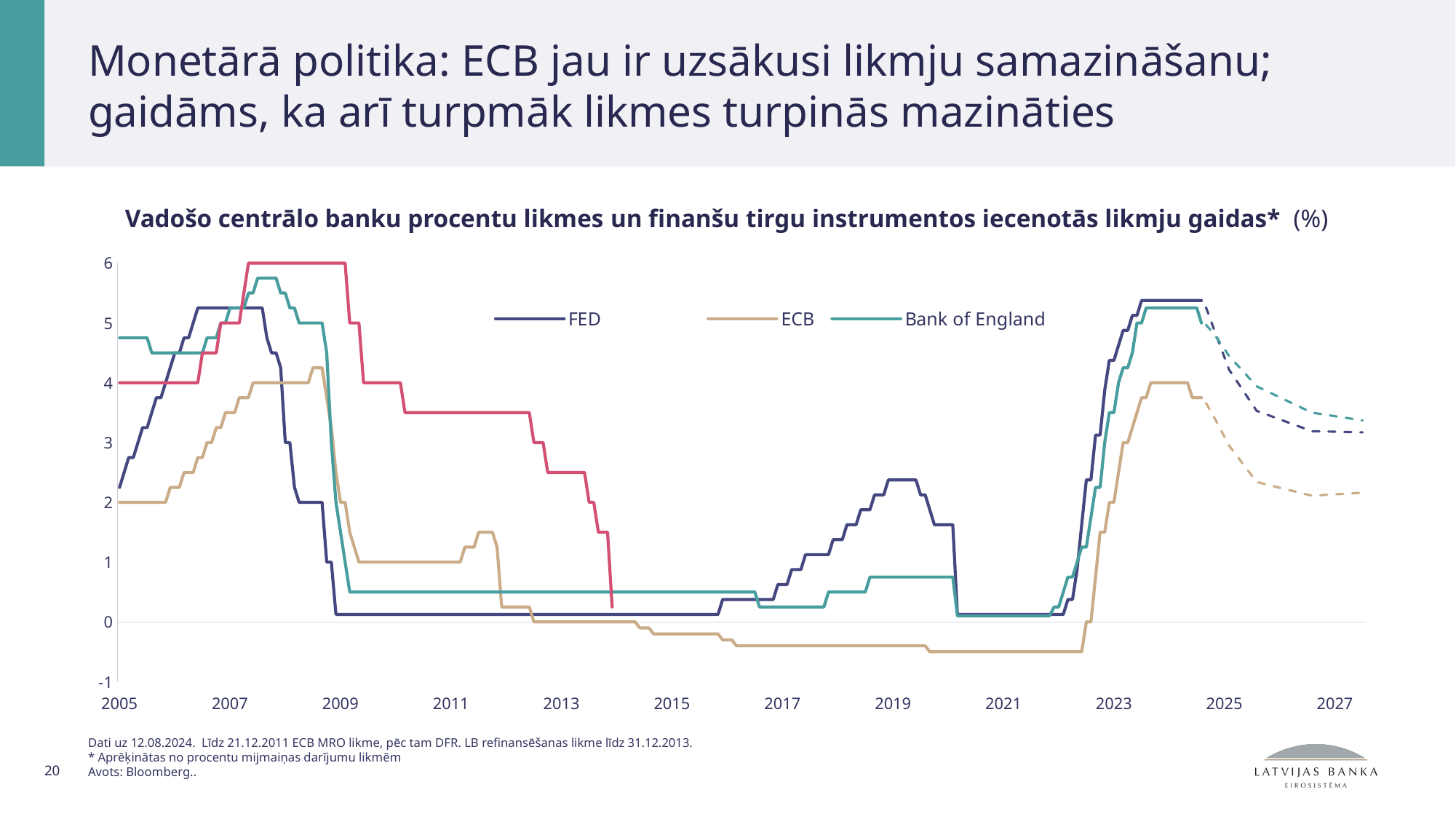
In early 2024, which is higher, the FED rate or the ECB rate? FED Is the Bank of England rate in 2010 greater or less than 1? less Do the dashed expectation lines rise or fall from 2025 to 2027? fall In 2020, which is higher, the FED rate or the ECB rate? FED Is the FED rate in early 2024 greater or less than 5? greater Is the ECB rate in 2020 greater or less than 0? less What kind of chart is shown on the slide? line chart How many series does the chart legend list? 3 What colour is the ECB line in the chart? tan/beige Which series are listed in the chart legend? FED, ECB, Bank of England